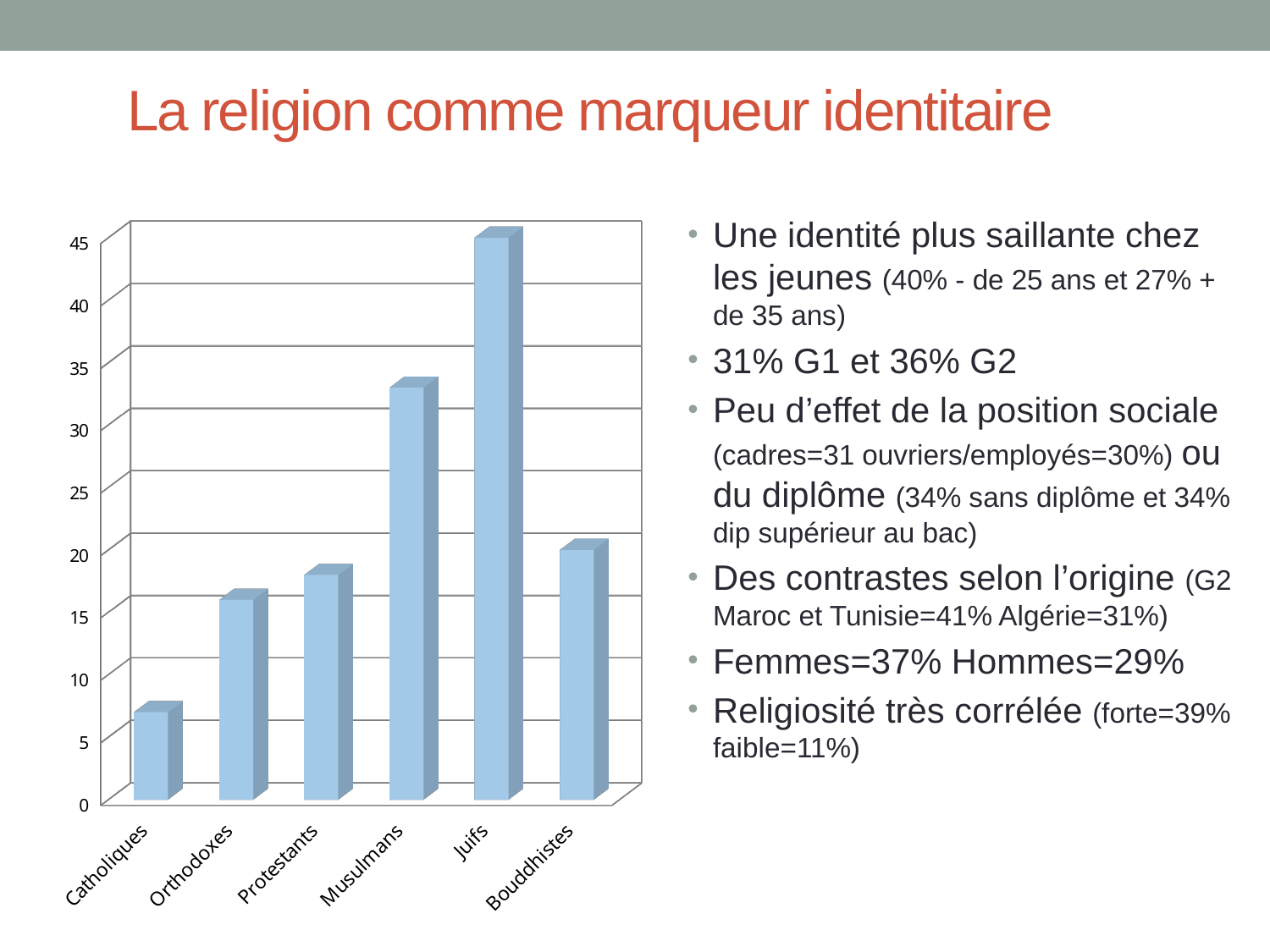
What kind of chart is shown on the slide? bar chart Is the value for Juifs greater or less than 40? greater Is the value for Protestants greater or less than 25? less Is the value for Orthodoxes greater or less than 20? less How many categories are shown on the x axis of the chart? 6 Which is larger, the value for Musulmans or the value for Protestants? Musulmans Which is larger, the value for Bouddhistes or the value for Catholiques? Bouddhistes Which category has the lowest bar in the chart? Catholiques What is the highest tick value shown on the vertical axis of the chart? 45 Which category has the highest bar in the chart? Juifs